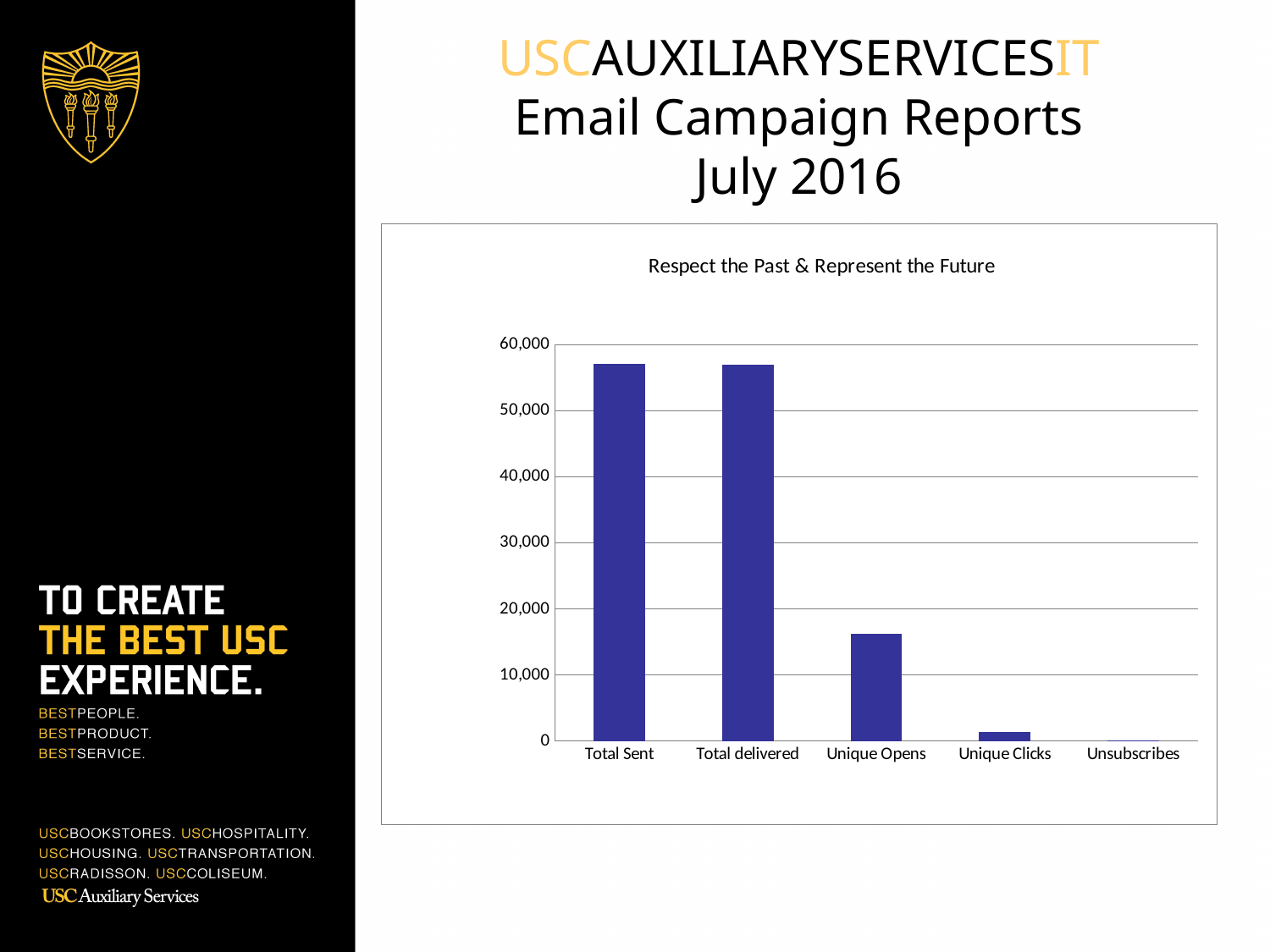
Is the value for Total delivered greater or less than 50,000? greater How many categories are shown on the x axis of the chart? 5 What is the highest value labelled on the vertical axis of the chart? 60,000 Is the value for Total Sent greater or less than 50,000? greater Is the value for Unique Opens greater or less than 10,000? greater Do the bar values generally rise or fall from left to right across the x axis? Fall Which is larger, the value for Unique Opens or the value for Unique Clicks? Unique Opens What kind of chart is shown on the slide? Bar chart Which category has the lowest value in the chart? Unsubscribes What is the title of the chart? Respect the Past & Represent the Future